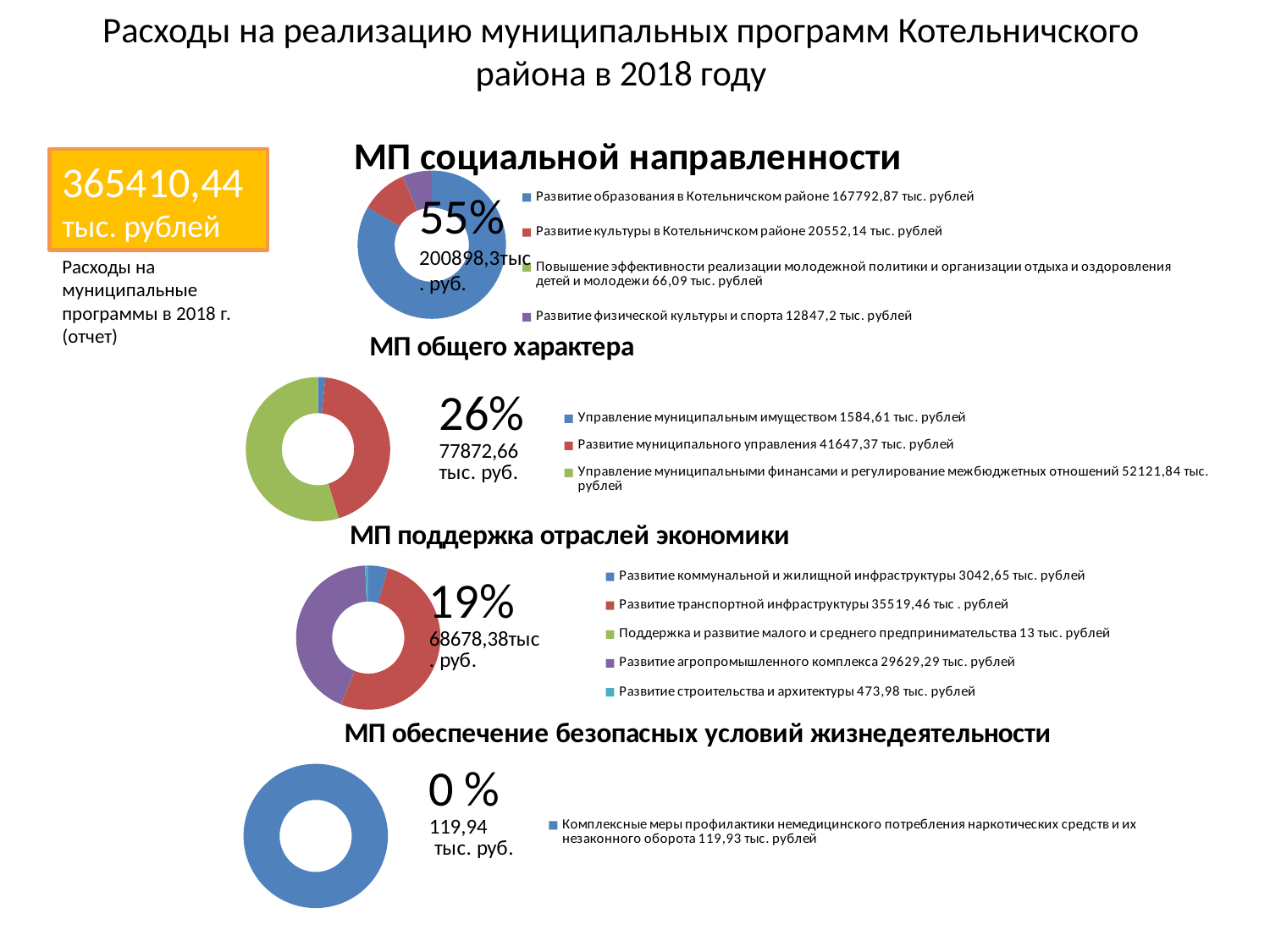
How many categories does the legend of the "МП общего характера" chart list? 3 In the "МП социальной направленности" chart, what is the difference between "Развитие образования" (167792,87) and "Развитие культуры" (20552,14)? 147240,73 тыс. рублей In the "МП общего характера" chart, which category has the largest value? Управление муниципальными финансами и регулирование межбюджетных отношений In the "МП поддержка отраслей экономики" chart, which is larger: "Развитие транспортной инфраструктуры" or "Развитие агропромышленного комплекса"? Развитие транспортной инфраструктуры What total value is printed in the centre of the "МП обеспечение безопасных условий жизнедеятельности" chart? 119,94 тыс. руб. In the "МП поддержка отраслей экономики" chart, what is the value for "Поддержка и развитие малого и среднего предпринимательства"? 13 тыс. рублей In the "МП социальной направленности" chart, which category has the smallest value? Повышение эффективности реализации молодежной политики и организации отдыха и оздоровления детей и молодежи How many categories does the legend of the "МП поддержка отраслей экономики" chart list? 5 What kind of chart is used for "МП социальной направленности"? Doughnut (pie) chart In the "МП социальной направленности" chart, what is the value for "Развитие образования в Котельничском районе"? 167792,87 тыс. рублей What share of total expenditure does the "МП социальной направленности" chart show? 55% In the "МП общего характера" chart, what is the difference between "Управление муниципальными финансами" (52121,84) and "Развитие муниципального управления" (41647,37)? 10474,47 тыс. рублей